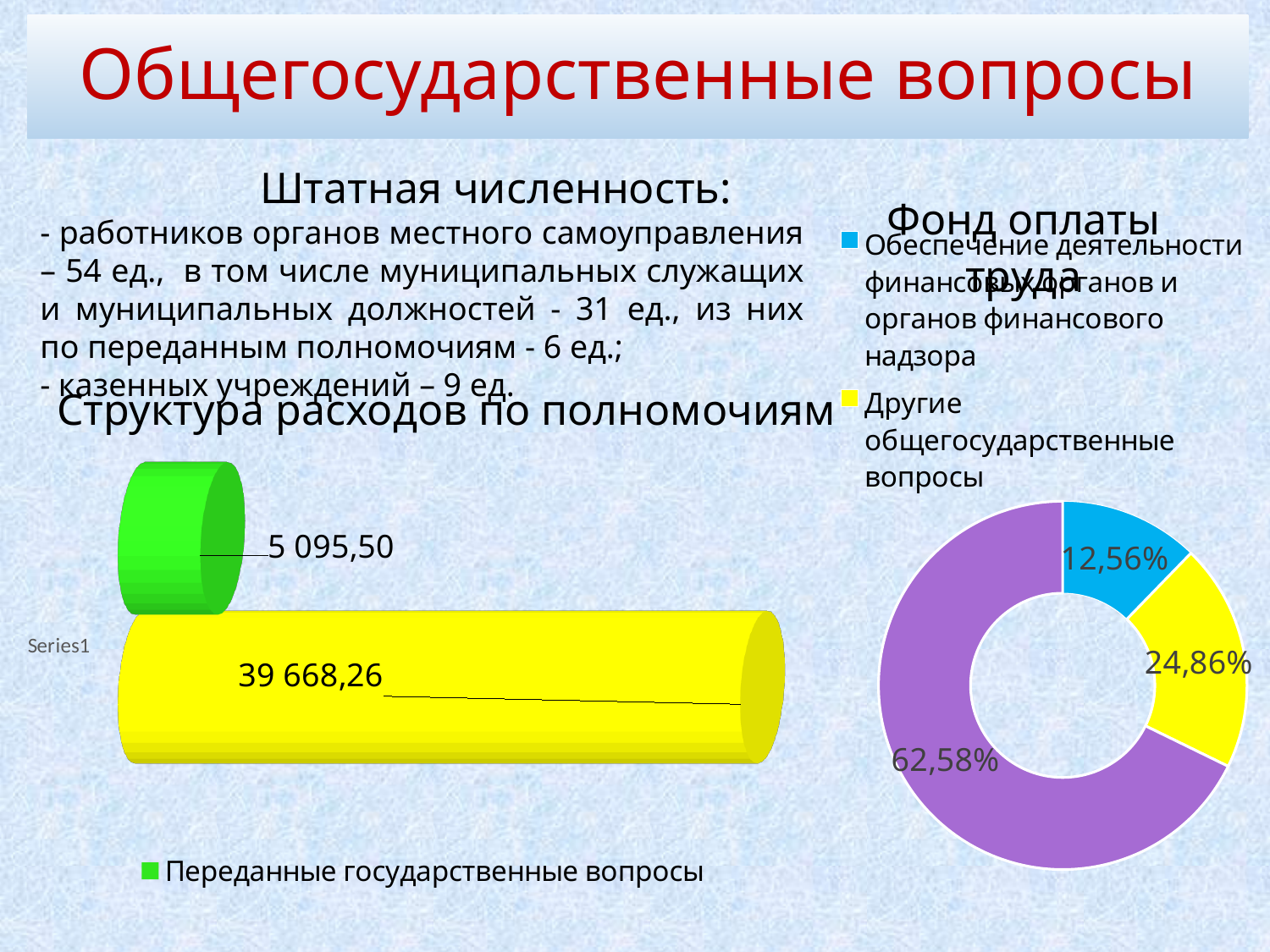
In the chart 'Фонд оплаты труда', what share is shown for 'Обеспечение деятельности финансовых органов и органов финансового надзора'? 12,56% In the chart 'Структура расходов по полномочиям', what value is shown for 'Переданные государственные вопросы'? 5 095,50 In the chart 'Фонд оплаты труда', what share is shown for 'Другие общегосударственные вопросы'? 24,86% What kind of chart is 'Структура расходов по полномочиям'? bar chart In the chart 'Фонд оплаты труда', what is the share of the smallest slice? 12,56% In the chart 'Структура расходов по полномочиям', what is the difference between the yellow bar value and the green bar value? 34 572,76 In the chart 'Структура расходов по полномочиям', which bar is larger, the yellow one or the green one? the yellow one In the chart 'Структура расходов по полномочиям', how many bars are plotted? 2 In the chart 'Фонд оплаты труда', what is the difference between the share for 'Другие общегосударственные вопросы' and the share for 'Обеспечение деятельности финансовых органов и органов финансового надзора'? 12,30% In the chart 'Фонд оплаты труда', how many slices does the doughnut have? 3 In the chart 'Фонд оплаты труда', what is the share of the largest slice? 62,58% In the chart 'Структура расходов по полномочиям', what value is printed on the yellow bar? 39 668,26